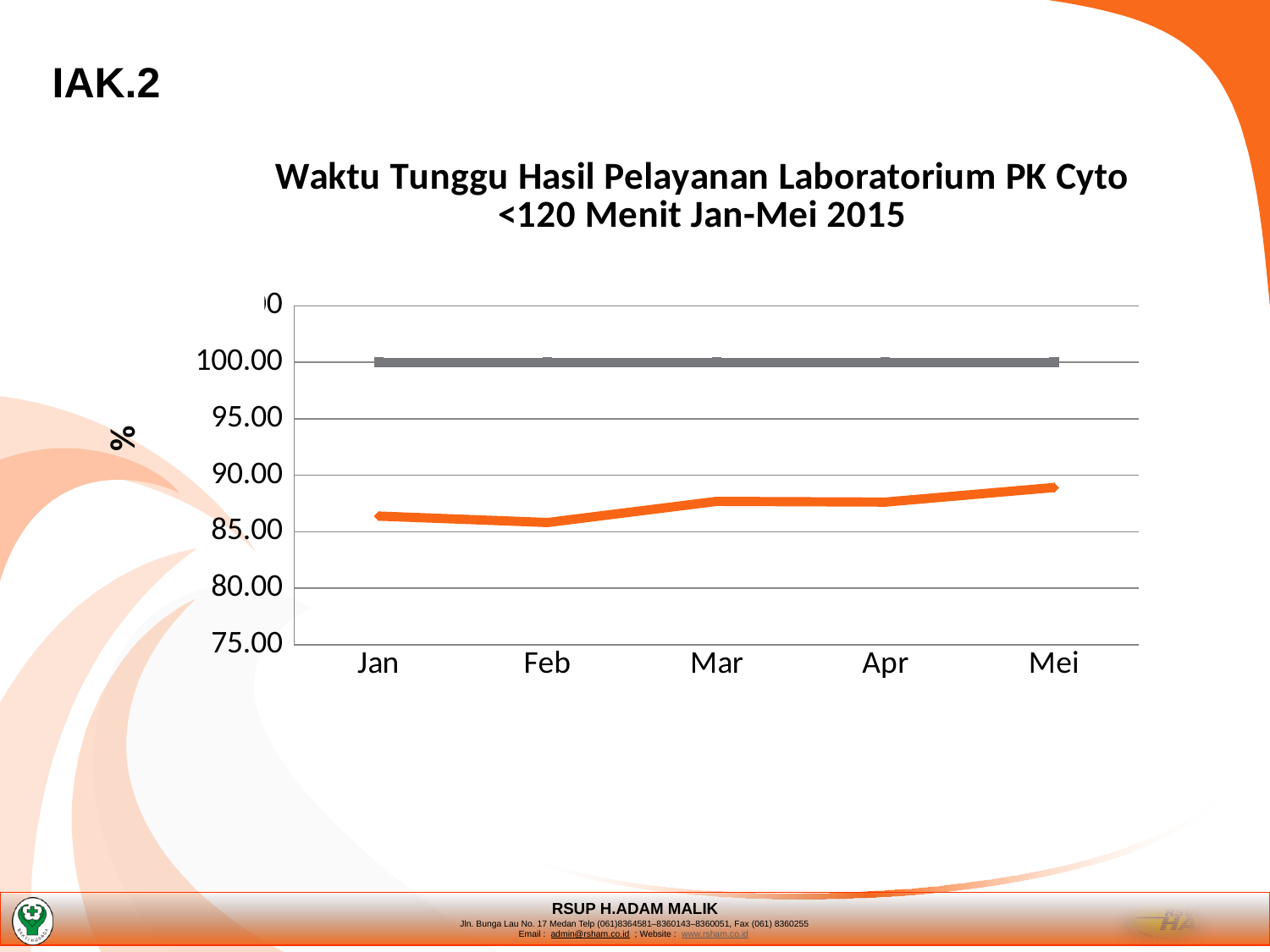
Does the orange line generally rise or fall from Feb to Mei? rise Which line is higher in every month, the gray line or the orange line? the gray line How many months are shown on the x axis of the chart? 5 What kind of chart is shown on the slide? line chart Which is larger for the orange line, the value for Feb or the value for Mei? Mei What label is shown on the y axis of the chart? % Is the value of the orange line for Feb greater or less than 90.00? less In which month does the orange line reach its highest value? Mei What value does the gray line sit at across all months? 100.00 Is the value of the orange line for Mei greater or less than 85.00? greater What is the title of the chart? Waktu Tunggu Hasil Pelayanan Laboratorium PK Cyto <120 Menit Jan-Mei 2015 Is the value of the orange line for Jan greater or less than 90.00? less